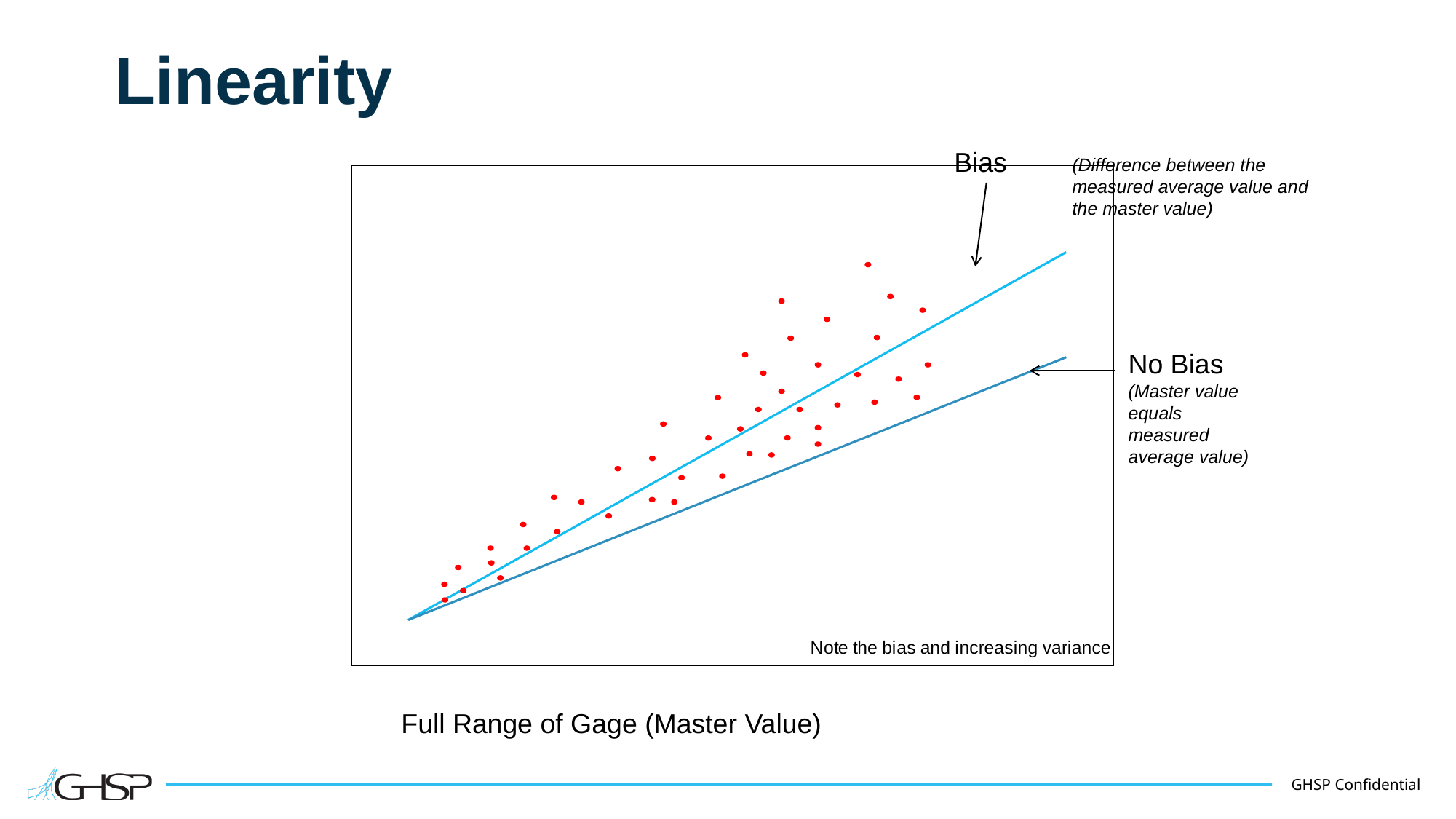
Does the spread (variance) of the plotted points increase or decrease along the x axis? increase Do the plotted points rise or fall as the master value increases along the x axis? rise What kind of chart is shown on the slide? scatter chart What is the label of the x axis of the chart? Full Range of Gage (Master Value) What are the labels of the two lines drawn through the points? Bias and No Bias At the right-hand end of the chart, which line is higher, the Bias line or the No Bias line? Bias Which of the two lines is steeper, the Bias line or the No Bias line? Bias